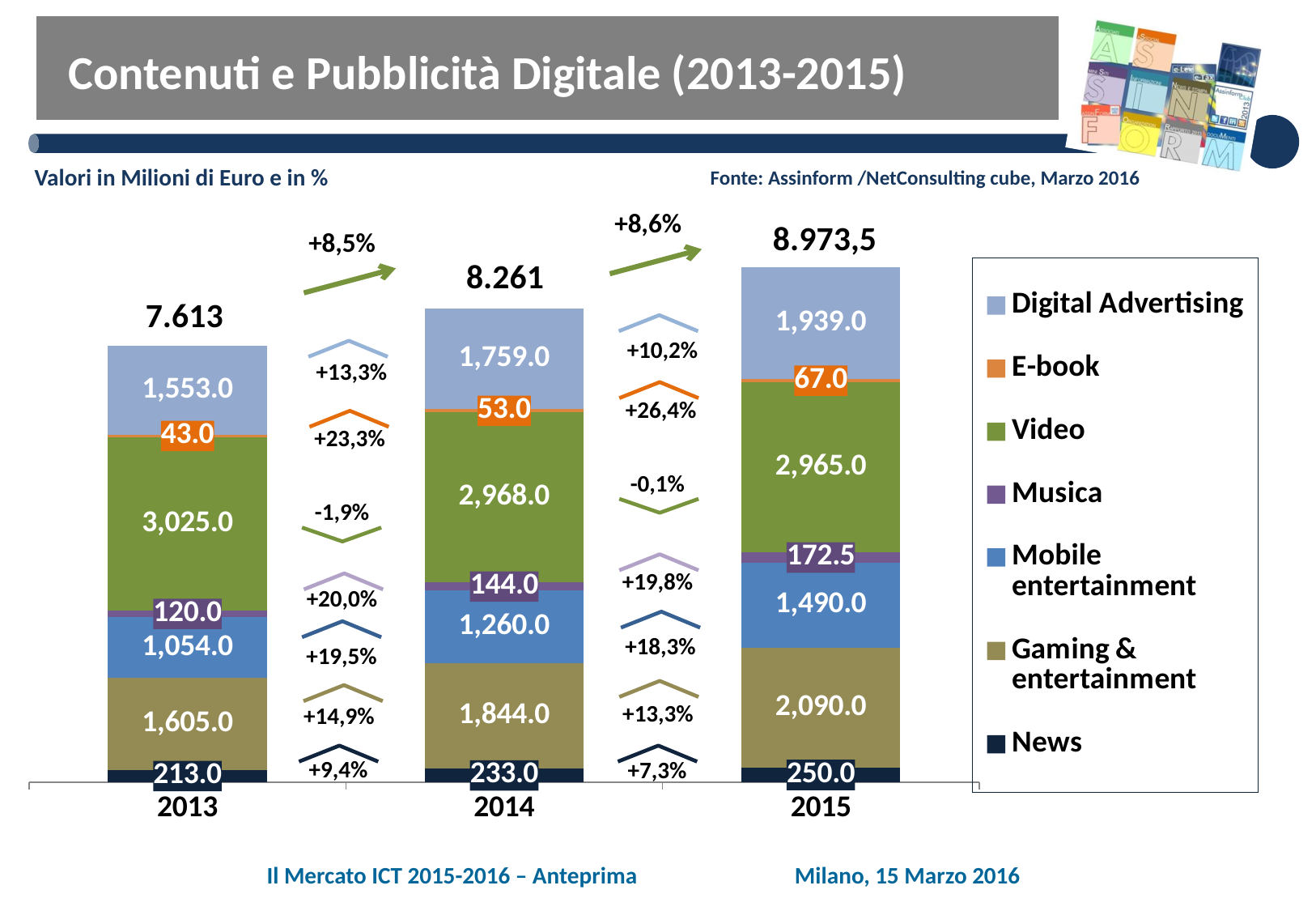
How many series does the legend list? 7 What is the difference between the Gaming & entertainment values for 2015 and 2014? 246.0 How many years are shown on the x axis? 3 Which series has the largest segment in the 2015 bar? Video What is the total shown above the 2013 stacked bar? 7.613 Which series has the smallest segment in the 2013 bar? E-book Which is larger, Digital Advertising in 2013 or Gaming & entertainment in 2013? Gaming & entertainment in 2013 What is the value for Video in 2014? 2,968.0 What is the value for Mobile entertainment in 2015? 1,490.0 What is the total shown above the 2015 stacked bar? 8.973,5 Do the yearly totals rise or fall from 2013 to 2015? rise What is the value for E-book in 2013? 43.0